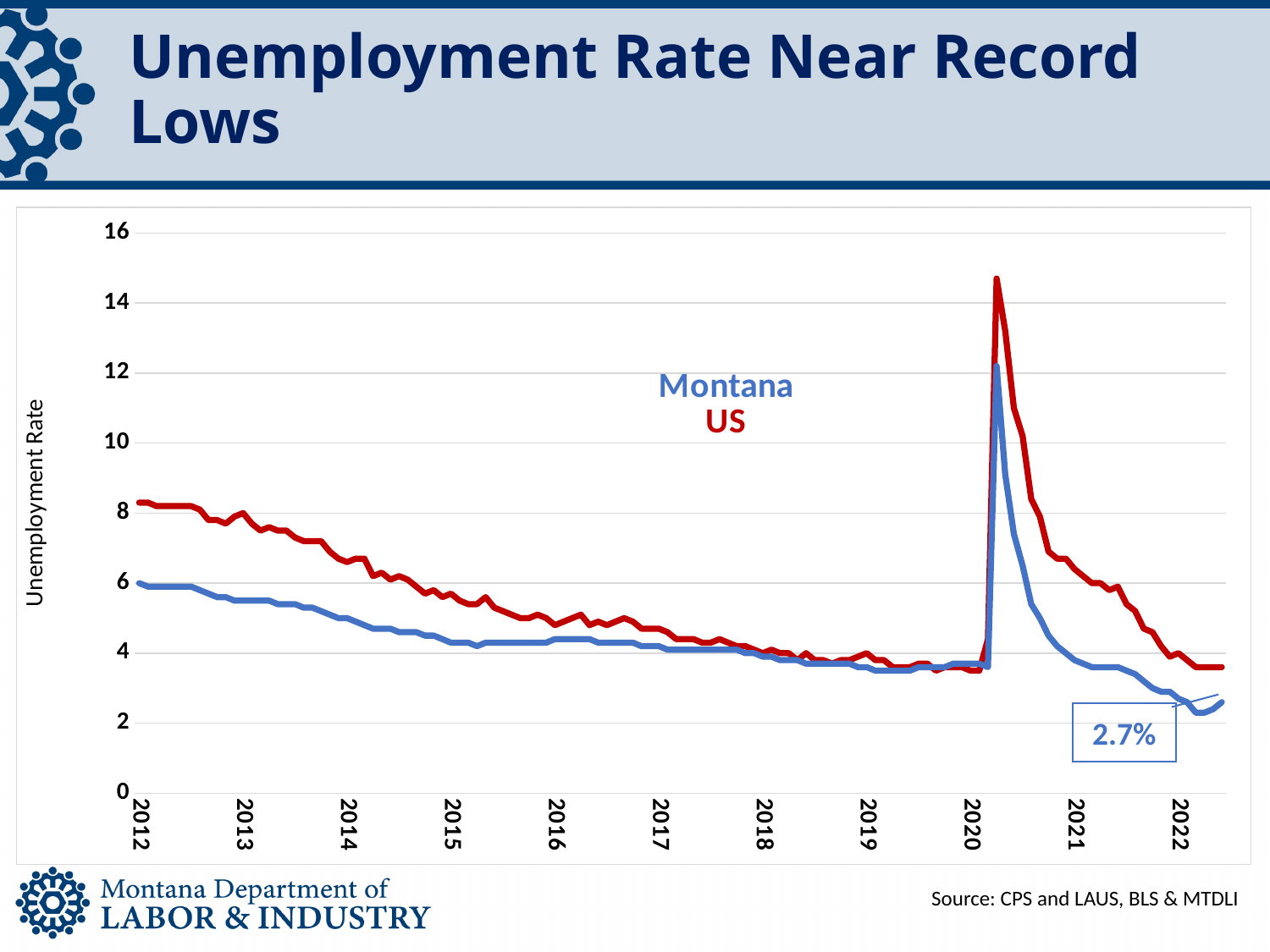
What kind of chart is shown on the slide? line chart What are the names of the two series plotted on the chart? Montana and US Is the peak value for US in 2020 greater or less than 14? greater Which series reached the higher peak in 2020, Montana or US? US At the start of 2012, which series has the higher unemployment rate, Montana or US? US Is the peak value for Montana in 2020 greater or less than 10? greater Does the Montana unemployment rate rise or fall from 2012 to 2019? fall How many series are plotted on the chart? 2 How many year labels are shown on the x axis? 11 What is the labeled value for Montana at the end of the series in 2022? 2.7% What is the label on the y axis of the chart? Unemployment Rate Is the value for Montana at the start of 2012 greater or less than 8? less